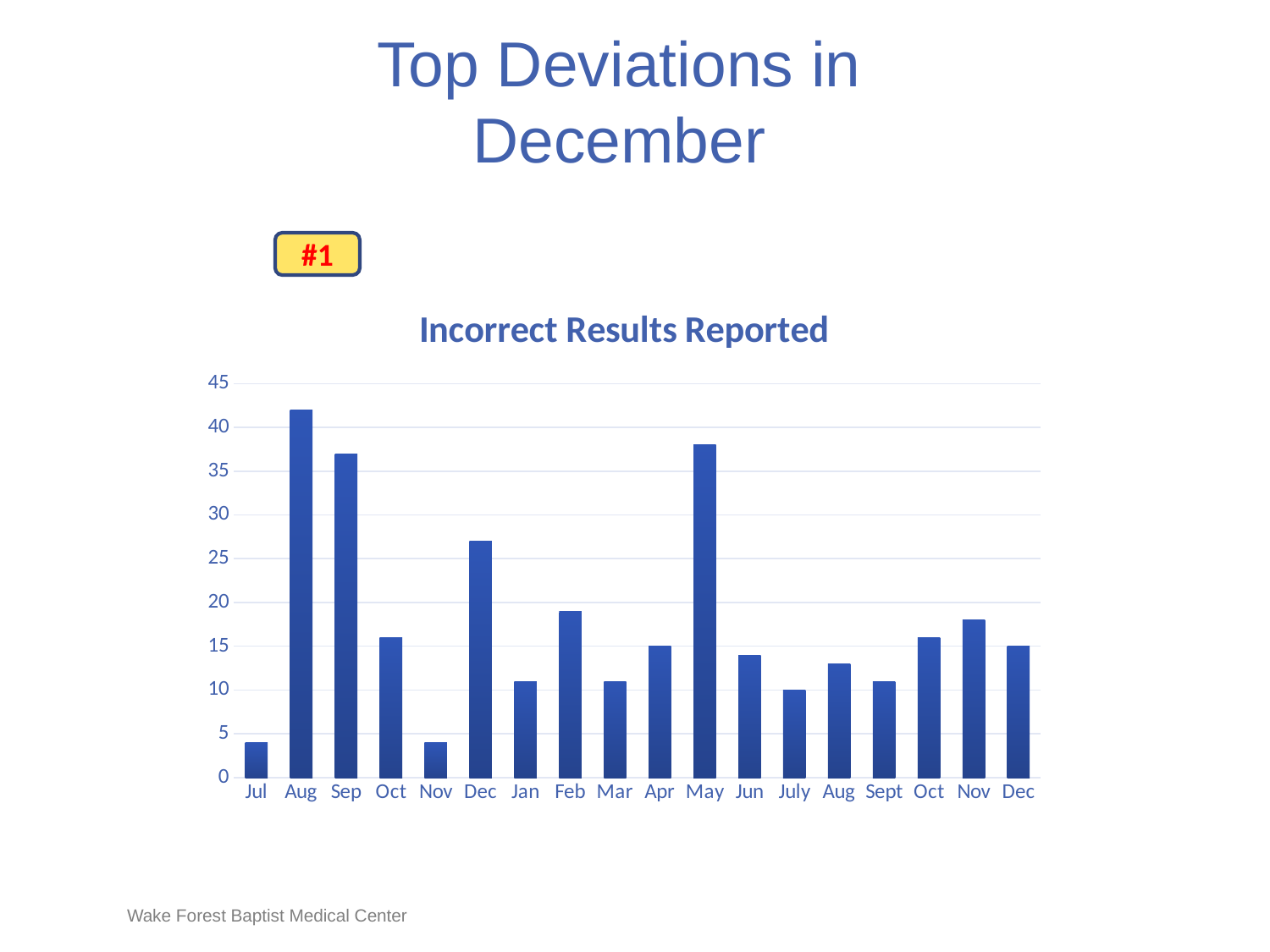
Is the value for May greater or less than 35? greater What type of chart is shown on the slide? bar chart How many bars (categories) are plotted in the chart? 18 Is the value for the first Aug bar greater or less than 40? greater Is the value for the second Nov bar greater or less than 15? greater Which month has the highest value in the chart? Aug (the first Aug) Which is larger, the value for Feb or the value for Mar? Feb What is the title of the chart? Incorrect Results Reported Which is larger, the value for the first Aug bar or the value for Sep? Aug